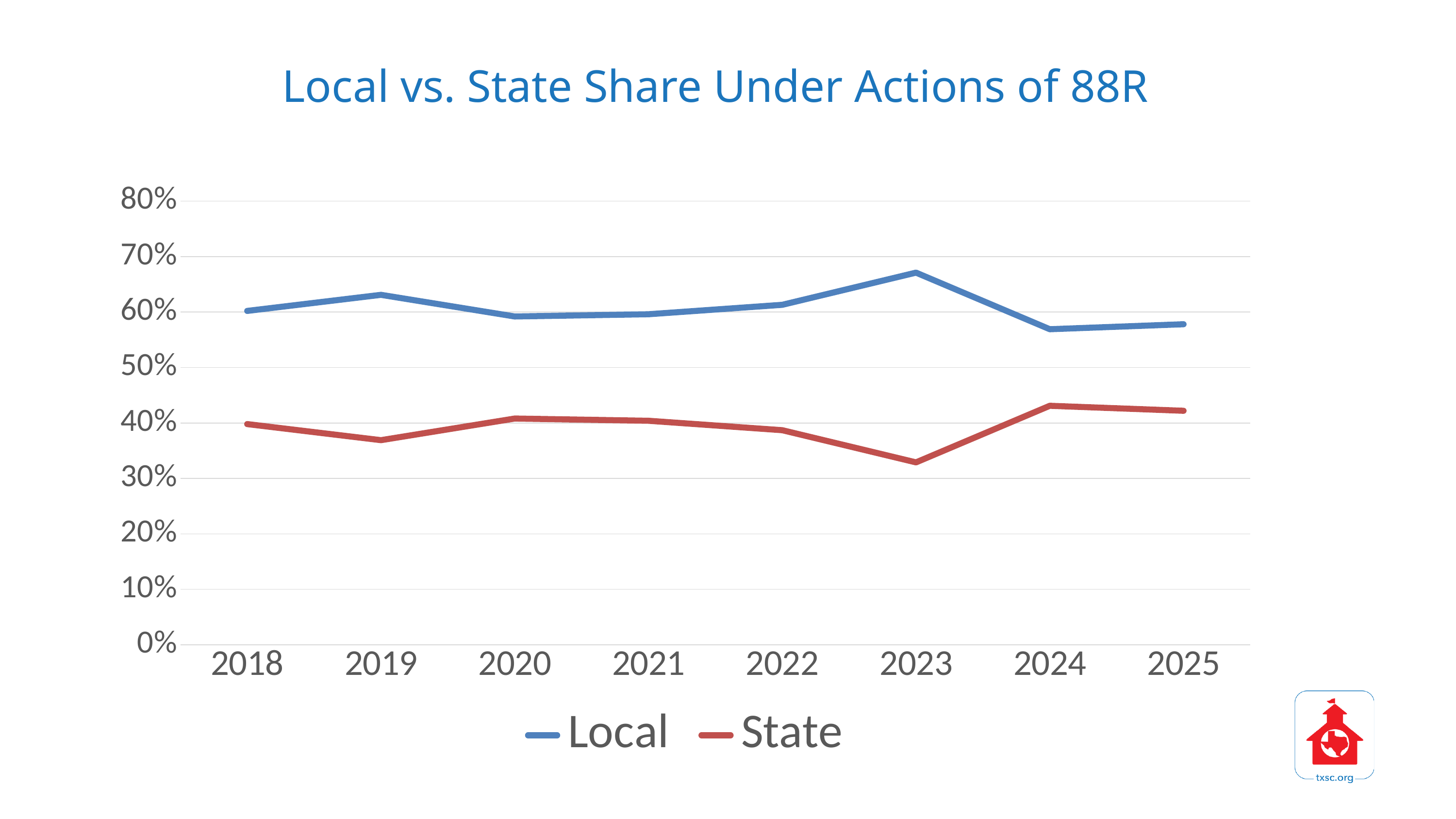
What is the title of the chart? Local vs. State Share Under Actions of 88R Is the value for State in 2024 greater or less than 40%? greater Is the value for State in 2023 greater or less than 40%? less What kind of chart is shown on the slide? line chart Is the value for Local in 2023 greater or less than 60%? greater In which year does the Local series reach its highest value? 2023 Which series has the larger value in 2023, Local or State? Local How many years are shown on the x axis? 8 In which year does the State series reach its lowest value? 2023 Does the State series rise or fall from 2023 to 2024? rise How many series does the legend list? 2